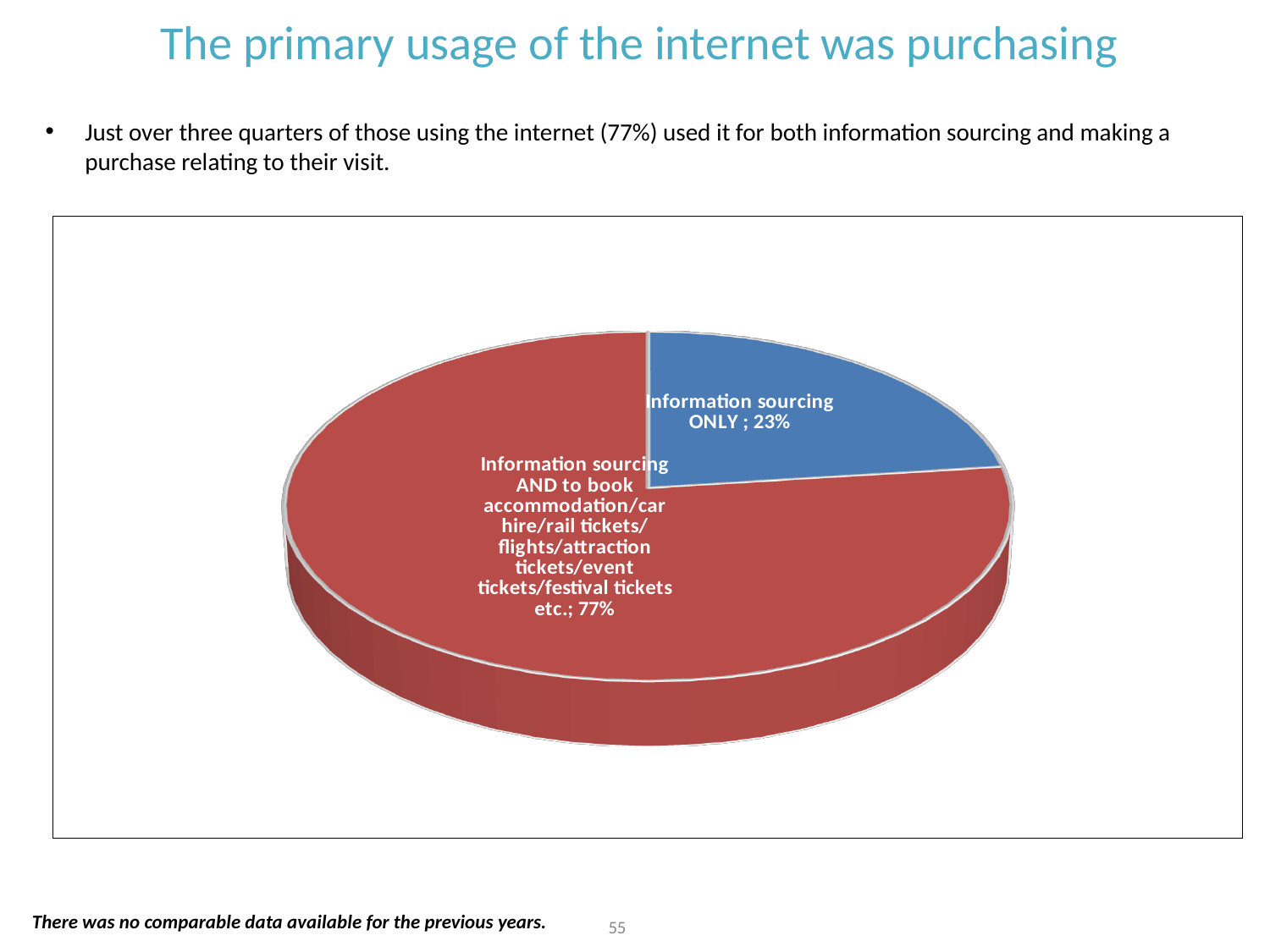
What colour is the 'Information sourcing AND to book...' slice? Red Which slice of the pie is the largest? Information sourcing AND to book accommodation/car hire/rail tickets/flights/attraction tickets/event tickets/festival tickets etc. What share of the pie is for 'Information sourcing AND to book accommodation/car hire/rail tickets/flights/attraction tickets/event tickets/festival tickets etc.'? 77% Which slice of the pie is the smallest? Information sourcing ONLY Which is larger: the 'Information sourcing ONLY' slice or the 'Information sourcing AND to book...' slice? Information sourcing AND to book... What is the difference in percentage points between the 'Information sourcing AND to book...' slice and the 'Information sourcing ONLY' slice? 54 percentage points What is the total of the two pie slice percentages? 100% What colour is the 'Information sourcing ONLY' slice? Blue How many slices does the pie chart have? 2 What share of the pie is labelled 'Information sourcing ONLY'? 23% What kind of chart is shown on the slide? Pie chart